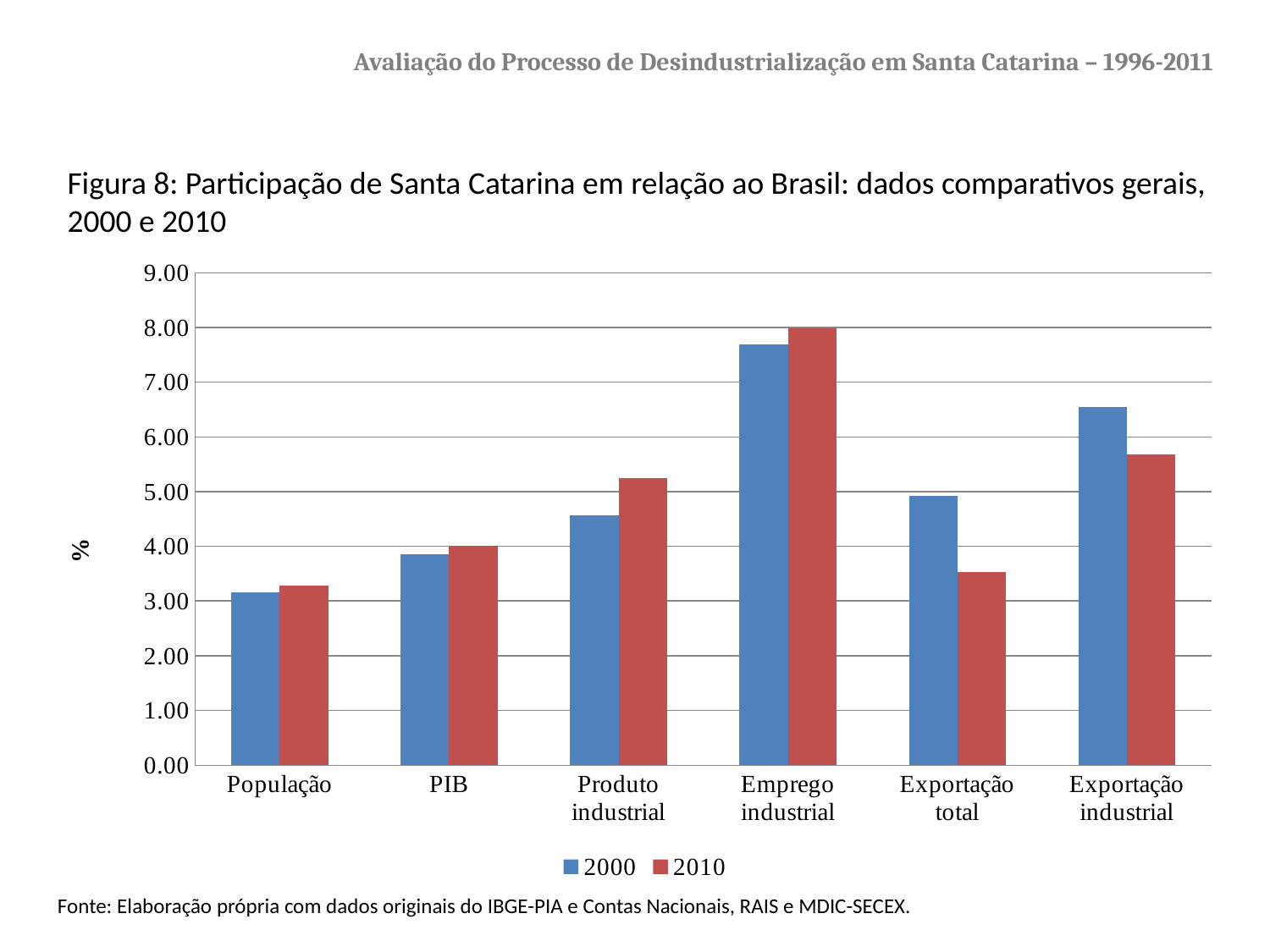
For Exportação total, which year has the larger value, 2000 or 2010? 2000 Is the value for Exportação industrial in 2000 greater or less than 6.00? greater How many series does the legend list? 2 What is the label of the y axis of the chart? % For Produto industrial, which year has the larger value, 2000 or 2010? 2010 How many categories are shown on the x axis of the chart? 6 Which category has the highest value for 2000? Emprego industrial Is the value for Exportação total in 2010 greater or less than 4.00? less For Exportação industrial, which year has the larger value, 2000 or 2010? 2000 Which category has the highest value for 2010? Emprego industrial What kind of chart is shown on the slide? bar chart Which category has the lowest value for 2000? População